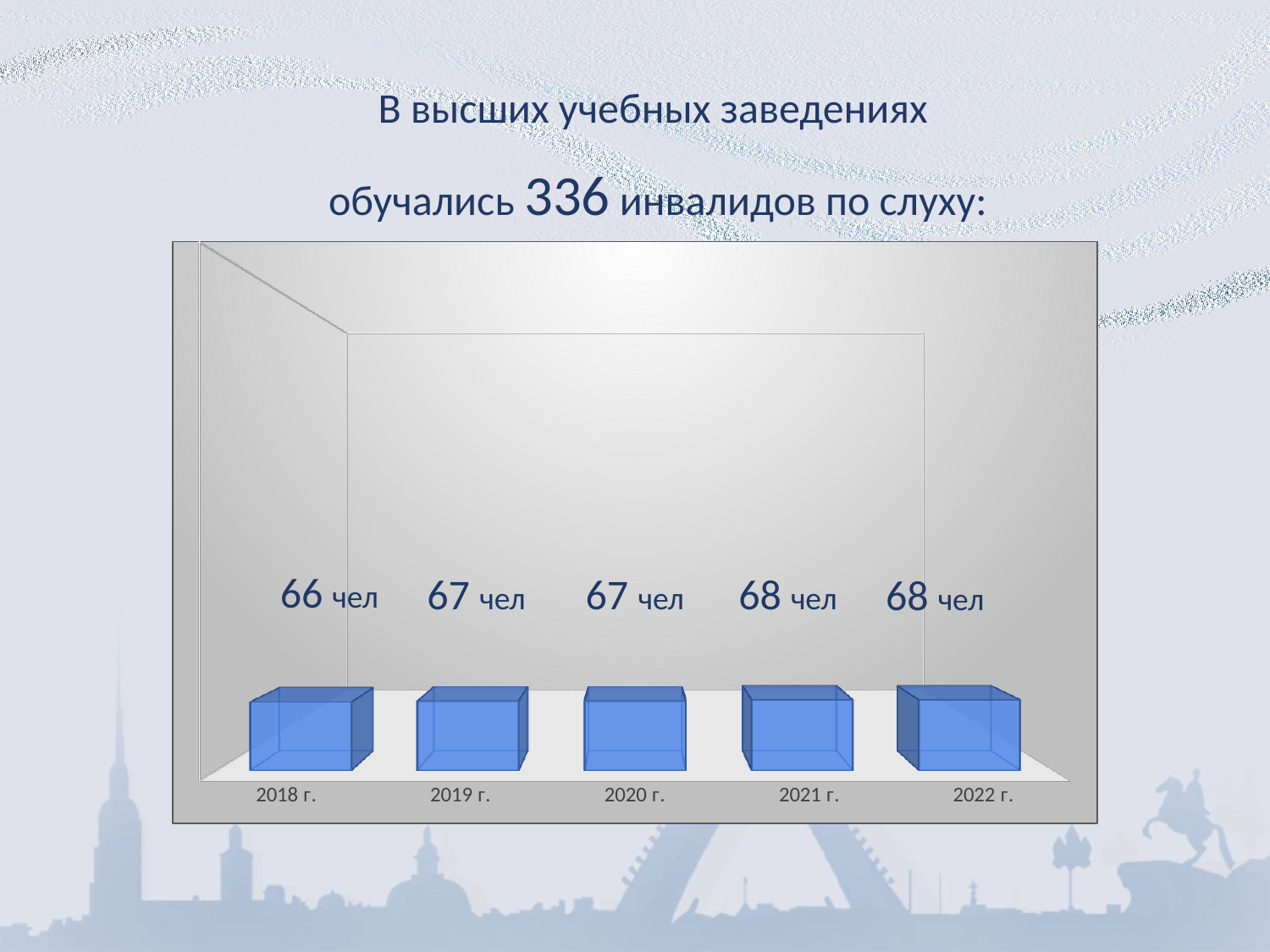
Do 2019 г. and 2020 г. have the same value? yes Which year has the lowest value? 2018 г. What is the difference between the values for 2022 г. and 2018 г.? 2 чел What colour are the bars in the chart? blue What is the total number of hearing-impaired students stated in the slide title? 336 Do the values rise or fall from 2018 г. to 2022 г.? rise What value is shown for 2018 г.? 66 чел What kind of chart is this? bar chart What value is shown for 2022 г.? 68 чел Which is larger, the value for 2019 г. or the value for 2021 г.? 2021 г. How many years are shown on the x axis? 5 What value is shown for 2020 г.? 67 чел